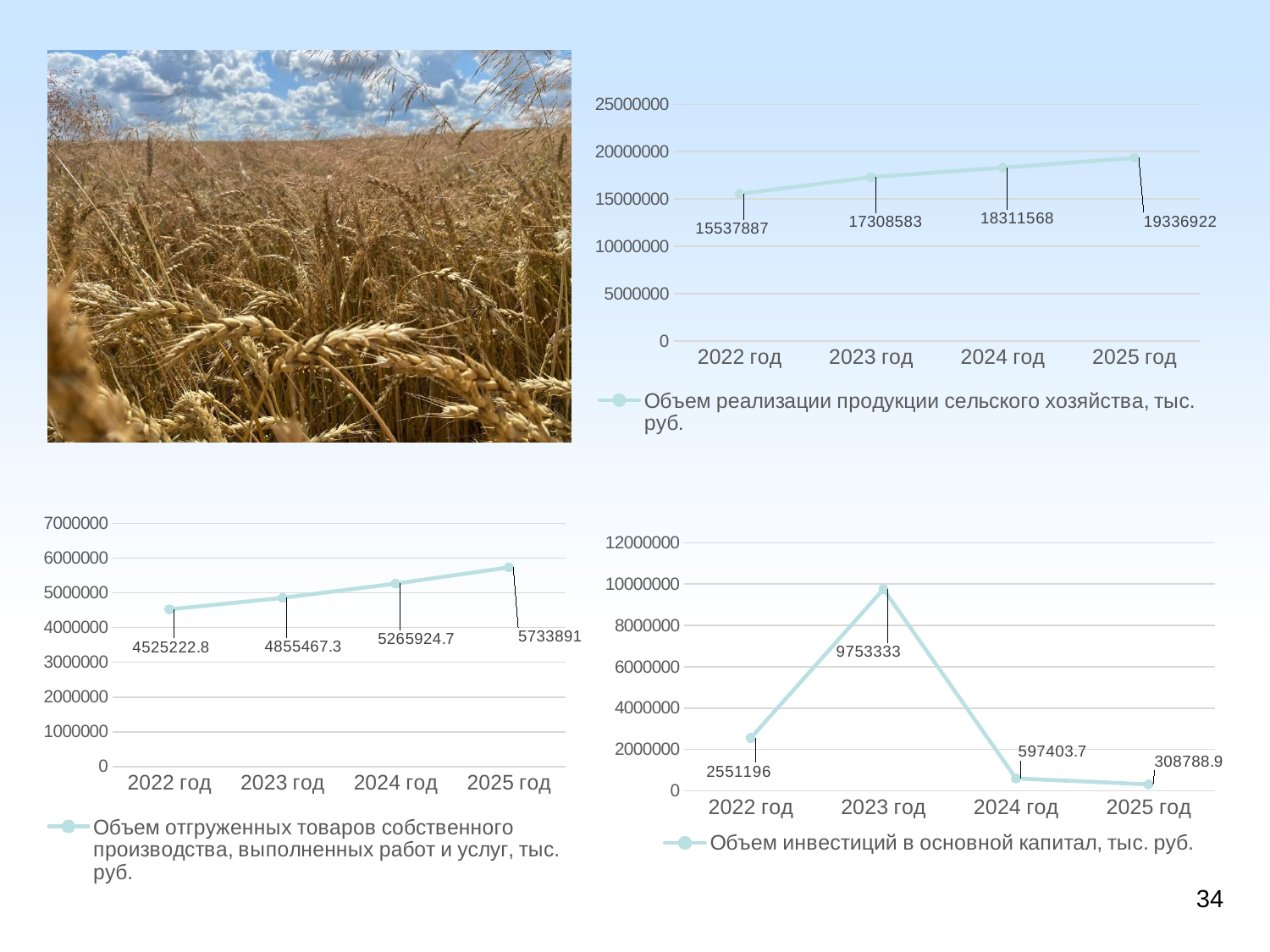
On the bottom-left chart (Объем отгруженных товаров собственного производства), how many years are plotted? 4 On the bottom-right chart (Объем инвестиций в основной капитал), what is the difference between the 2023 год and 2022 год values? 7202137 On the bottom-left chart (Объем отгруженных товаров собственного производства), which year has the highest value? 2025 год On the top-right chart (Объем реализации продукции сельского хозяйства), do the values rise or fall from 2022 год to 2025 год? rise What type of chart is the bottom-right chart (Объем инвестиций в основной капитал)? line chart On the bottom-right chart (Объем инвестиций в основной капитал), which year has the lowest value? 2025 год On the top-right chart (Объем реализации продукции сельского хозяйства), what is the value for 2025 год? 19336922 On the top-right chart (Объем реализации продукции сельского хозяйства), what is the value for 2022 год? 15537887 On the bottom-left chart (Объем отгруженных товаров собственного производства), what is the value for 2023 год? 4855467.3 On the bottom-right chart (Объем инвестиций в основной капитал), is the value for 2022 год larger or smaller than the value for 2024 год? larger On the top-right chart (Объем реализации продукции сельского хозяйства), what is the difference between the 2025 год and 2022 год values? 3799035 On the bottom-right chart (Объем инвестиций в основной капитал), what is the value for 2023 год? 9753333